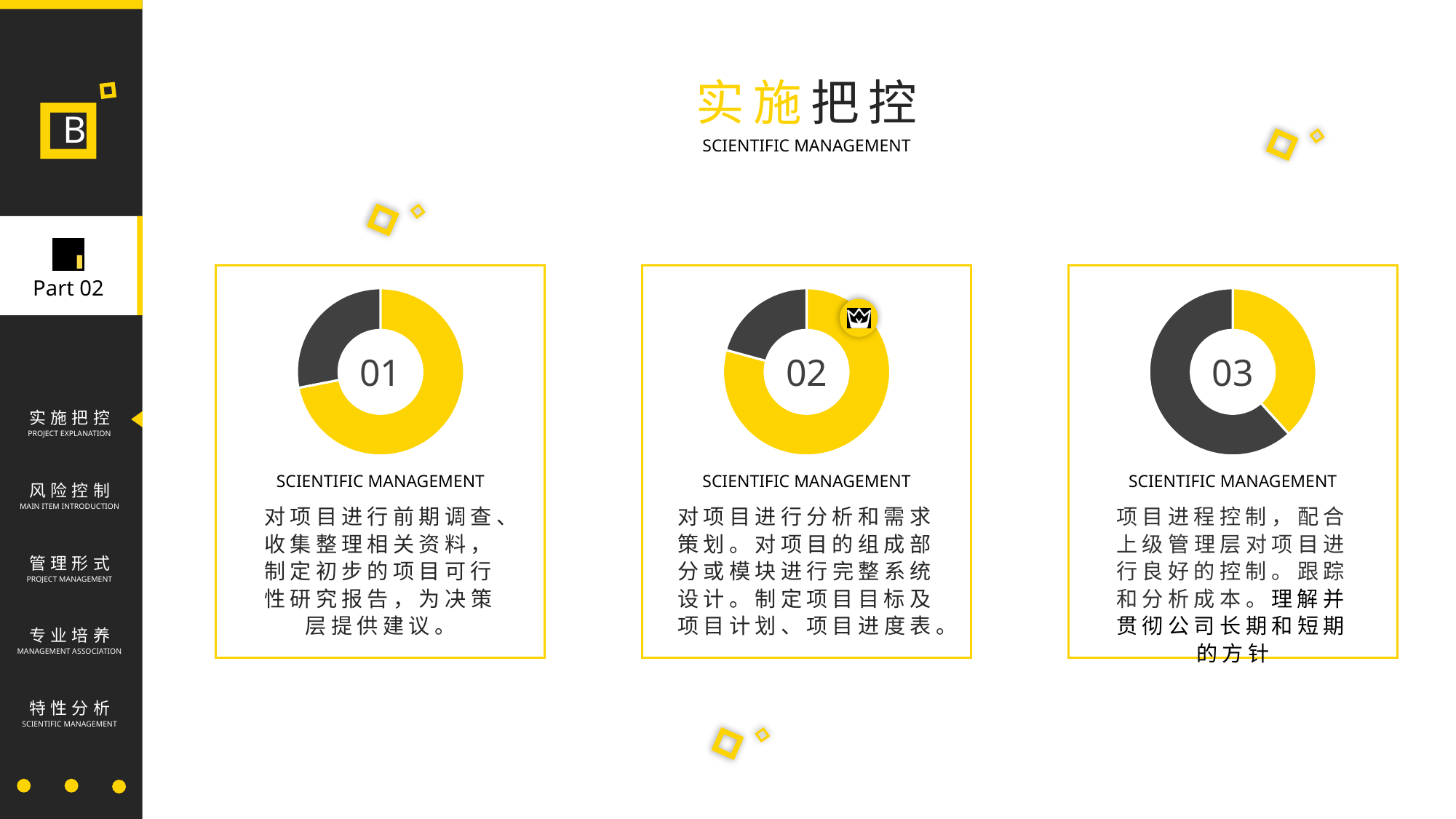
In the chart labelled 02, which slice is larger, the yellow one or the dark grey one? Yellow What number is printed in the centre of the middle donut chart? 02 What kind of chart is shown in the box labelled 01? Donut chart In the chart labelled 03, which slice is larger, the yellow one or the dark grey one? Dark grey How many charts are on the slide? 3 In the chart labelled 03, how many slices does the donut have? 2 What caption appears directly below each donut chart? SCIENTIFIC MANAGEMENT In the chart labelled 01, which slice is larger, the yellow one or the dark grey one? Yellow Which of the three donut charts has the smallest dark grey slice? 02 Which of the three donut charts has the largest dark grey slice? 03 In the chart labelled 01, how many slices does the donut have? 2